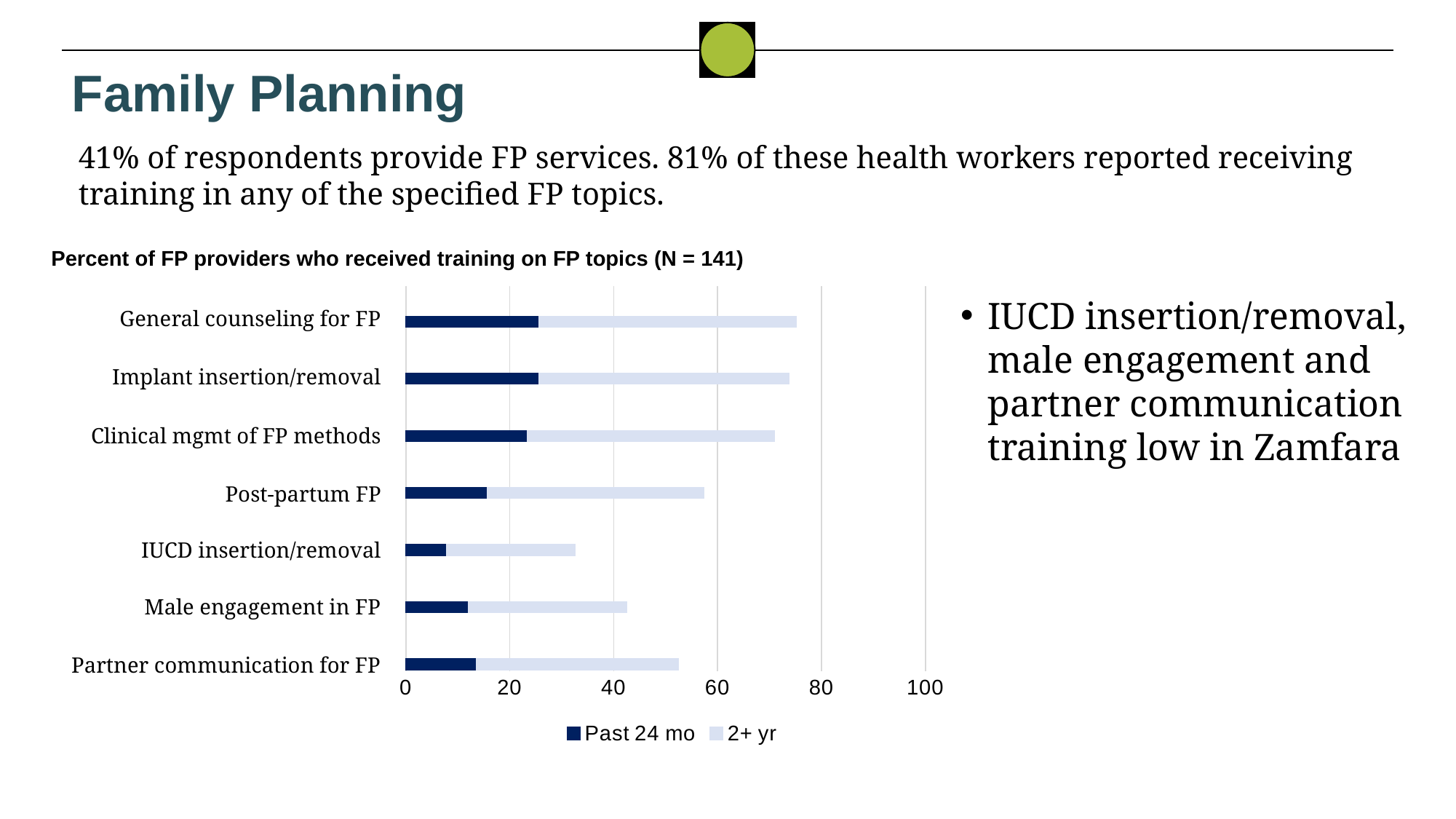
Which has the longer total bar: Male engagement in FP or Partner communication for FP? Partner communication for FP What are the two series named in the chart legend? Past 24 mo and 2+ yr Is the Past 24 mo value for IUCD insertion/removal greater or less than 20? less Is the total bar for General counseling for FP greater or less than 60? greater Which FP topic has the shortest total bar (lowest overall percent trained)? IUCD insertion/removal Is the total bar for Post-partum FP greater or less than 40? greater What is the title of the chart? Percent of FP providers who received training on FP topics (N = 141) What kind of chart is shown on the slide? bar chart How many series does the chart legend list? 2 How many FP topics (categories) are plotted in the chart? 7 Which has the longer total bar: Post-partum FP or IUCD insertion/removal? Post-partum FP